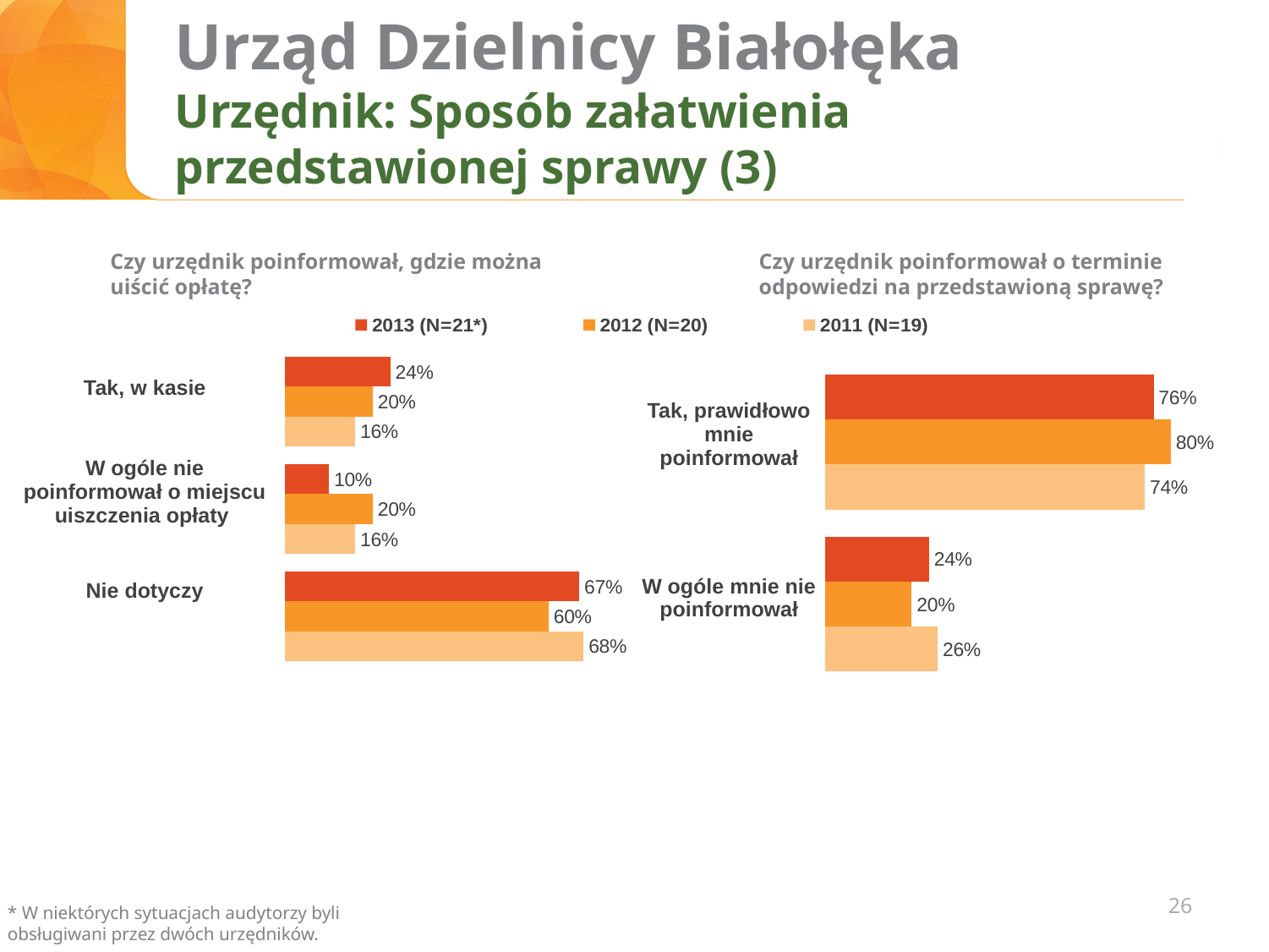
In the right chart ("Czy urzędnik poinformował o terminie odpowiedzi na przedstawioną sprawę?"), what is the 2011 value for "Tak, prawidłowo mnie poinformował"? 74% How many series does the legend list? 3 In the left chart ("Czy urzędnik poinformował, gdzie można uiścić opłatę?"), which category has the highest 2013 value? Nie dotyczy In the left chart ("Czy urzędnik poinformował, gdzie można uiścić opłatę?"), what is the 2013 value for "Tak, w kasie"? 24% In the right chart ("Czy urzędnik poinformował o terminie odpowiedzi na przedstawioną sprawę?"), what is the 2013 value for "W ogóle mnie nie poinformował"? 24% In the right chart ("Czy urzędnik poinformował o terminie odpowiedzi na przedstawioną sprawę?"), which year has the highest value for "Tak, prawidłowo mnie poinformował"? 2012 (N=20) What type of chart is used on this slide? Bar chart In the left chart ("Czy urzędnik poinformował, gdzie można uiścić opłatę?"), which category has the lowest 2013 value? W ogóle nie poinformował o miejscu uiszczenia opłaty In the left chart ("Czy urzędnik poinformował, gdzie można uiścić opłatę?"), what is the difference between the 2013 and 2012 values for "W ogóle nie poinformował o miejscu uiszczenia opłaty"? 10 percentage points In the left chart ("Czy urzędnik poinformował, gdzie można uiścić opłatę?"), which is larger for "Nie dotyczy": the 2013 value or the 2011 value? 2011 (68%) In the left chart ("Czy urzędnik poinformował, gdzie można uiścić opłatę?"), what is the 2012 value for "Nie dotyczy"? 60% In the right chart ("Czy urzędnik poinformował o terminie odpowiedzi na przedstawioną sprawę?"), what is the difference between the 2012 and 2011 values for "Tak, prawidłowo mnie poinformował"? 6 percentage points